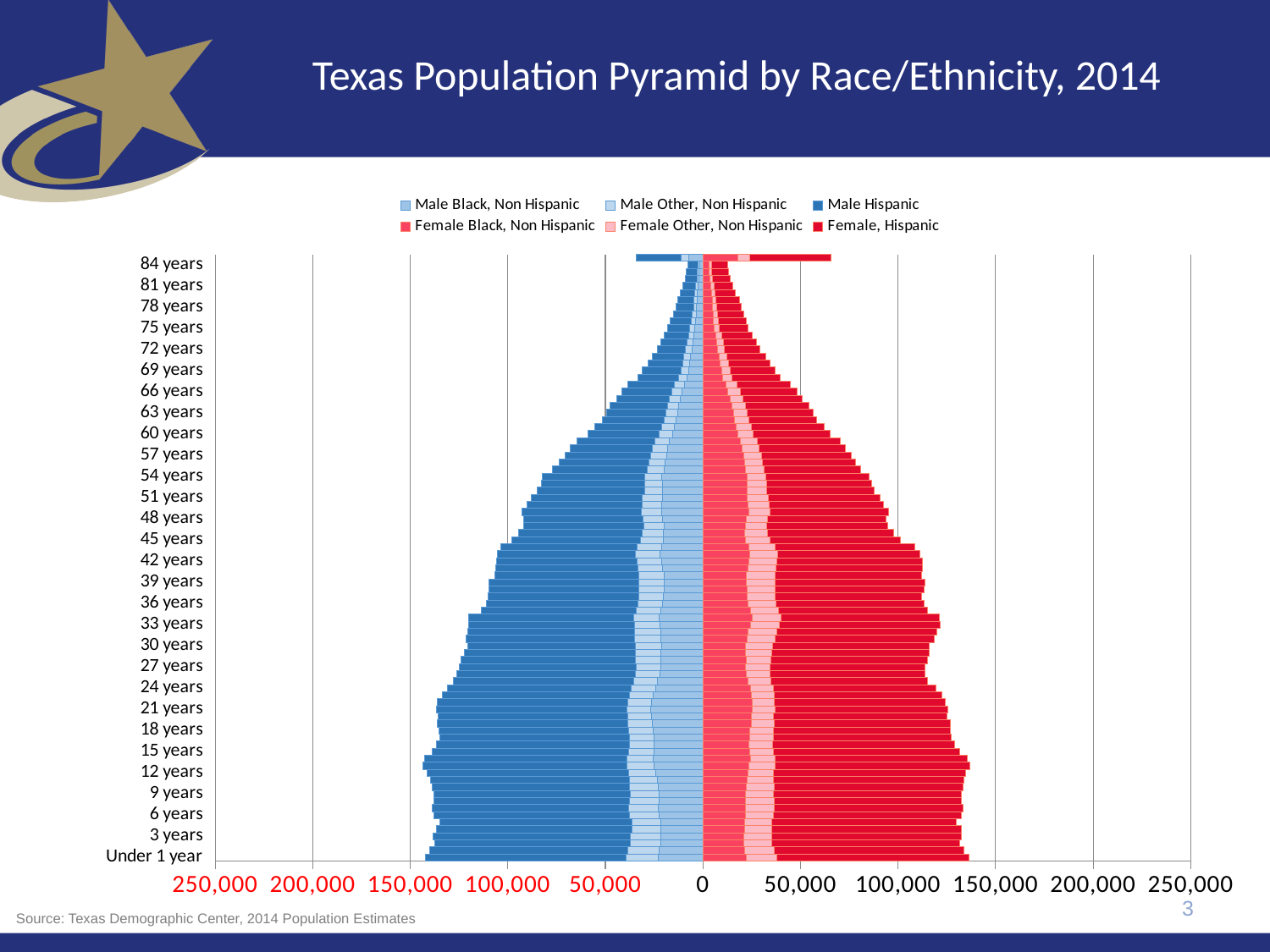
What kind of chart is shown on the slide? bar chart Is the total male population for 84 years greater or less than 50,000? less Which legend entry is shown in dark blue? Male Hispanic Is the total female population for Under 1 year greater or less than 100,000? greater Is the total male population for 72 years greater or less than 50,000? less How many series does the legend list? 6 Which has a longer total female bar, 33 years or 69 years? 33 years Do the total bar lengths generally increase or decrease as age rises from Under 1 year to 84 years? decrease Which has a longer total male bar, 12 years or 60 years? 12 years What is the title of the chart? Texas Population Pyramid by Race/Ethnicity, 2014